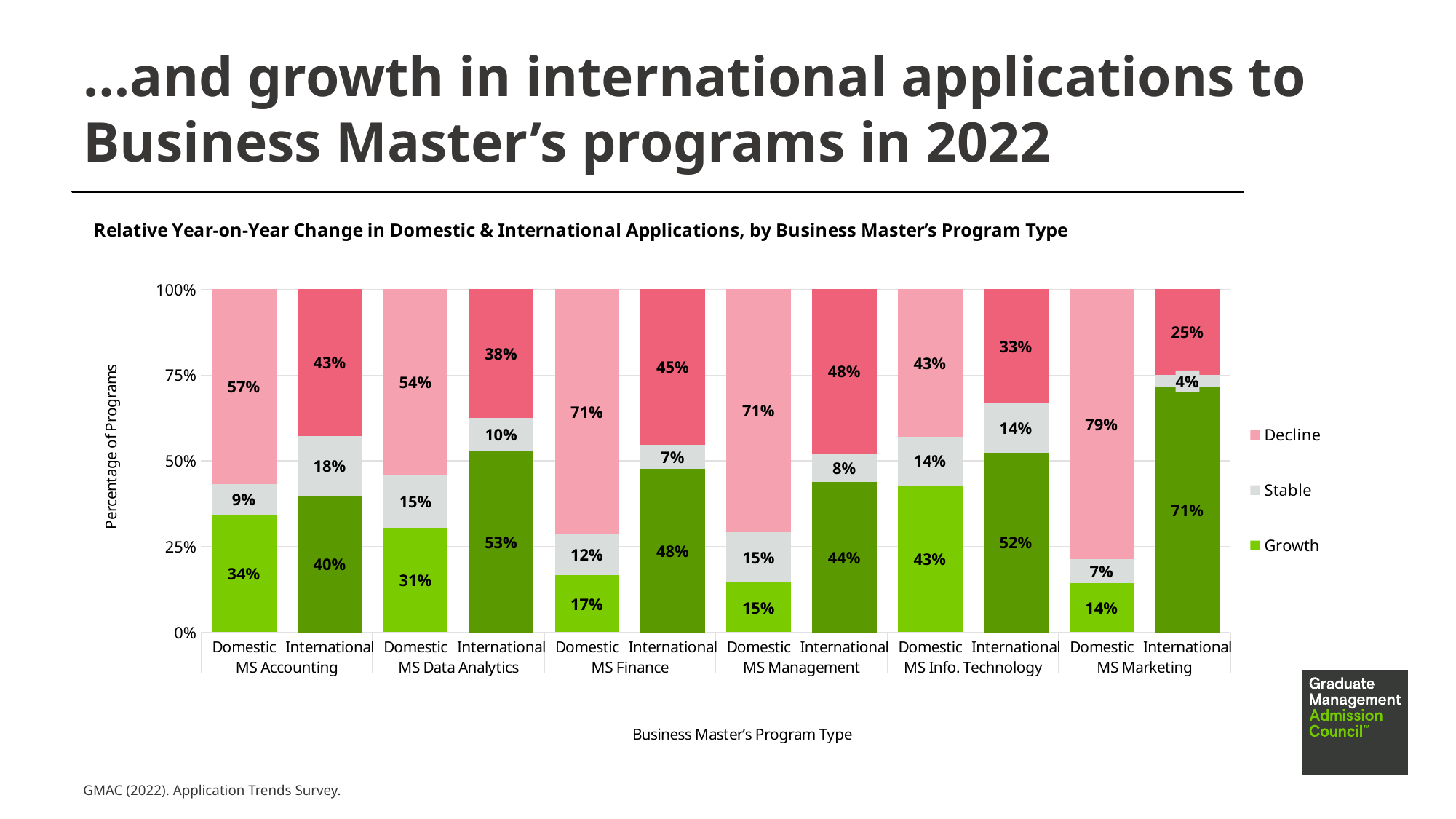
How many Business Master's program types are shown on the x axis? 6 What percentage of programs reported a decline in domestic applications for MS Finance? 71% For MS Accounting, which has the larger Decline share: Domestic or International applications? Domestic Which bar shows the highest Growth percentage? International MS Marketing For MS Data Analytics, how many percentage points higher is the Growth share for International applications than for Domestic applications? 22 percentage points How many series does the legend list? 3 What is the Stable share for International applications to MS Accounting programs? 18% What is the total of the Domestic MS Info. Technology bar (Growth + Stable + Decline)? 100% What kind of chart is shown on the slide? Stacked bar chart What are the three legend entries of the chart? Decline, Stable, Growth What percentage of programs reported growth in international applications for MS Marketing? 71% Which bar shows the lowest Growth percentage? Domestic MS Marketing